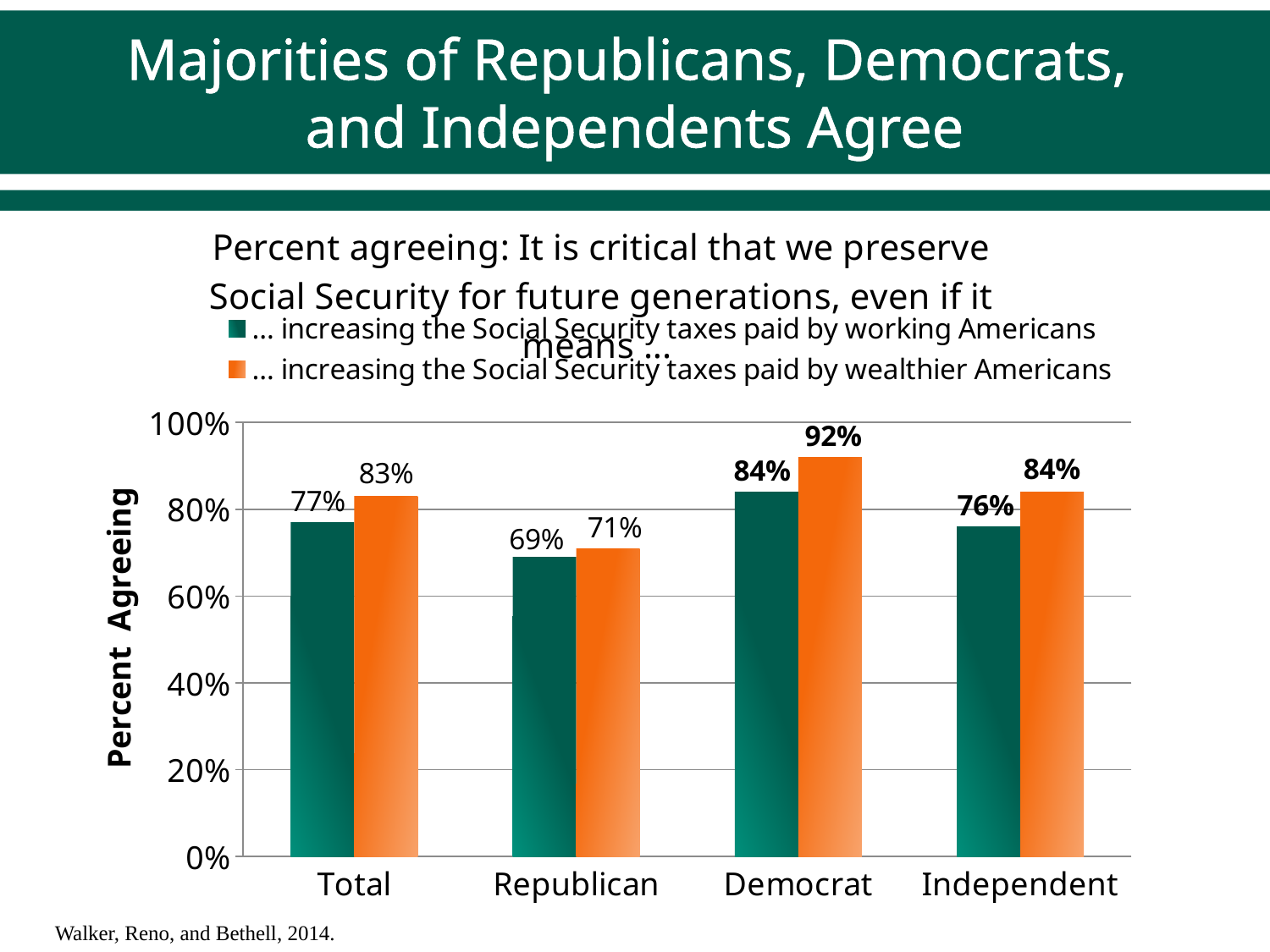
How many categories are shown on the x axis? 4 What kind of chart is shown on the slide? Bar chart Which is larger: the Total value for 'taxes paid by working Americans' or the Independent value for the same series? Total What is the value for Total in the 'increasing the Social Security taxes paid by wealthier Americans' series? 83% What percent of Democrats agree with preserving Social Security even if it means increasing taxes paid by wealthier Americans? 92% How many series does the legend list? 2 What is the value for Republican in the 'increasing the Social Security taxes paid by working Americans' series? 69% What is the label of the y axis? Percent Agreeing Which category has the lowest value for the 'taxes paid by wealthier Americans' series? Republican Which category has the highest value for the 'taxes paid by working Americans' series? Democrat What is the difference between the Democrat and Republican values in the 'taxes paid by wealthier Americans' series? 21% What is the difference between the two series' values for Independent? 8%